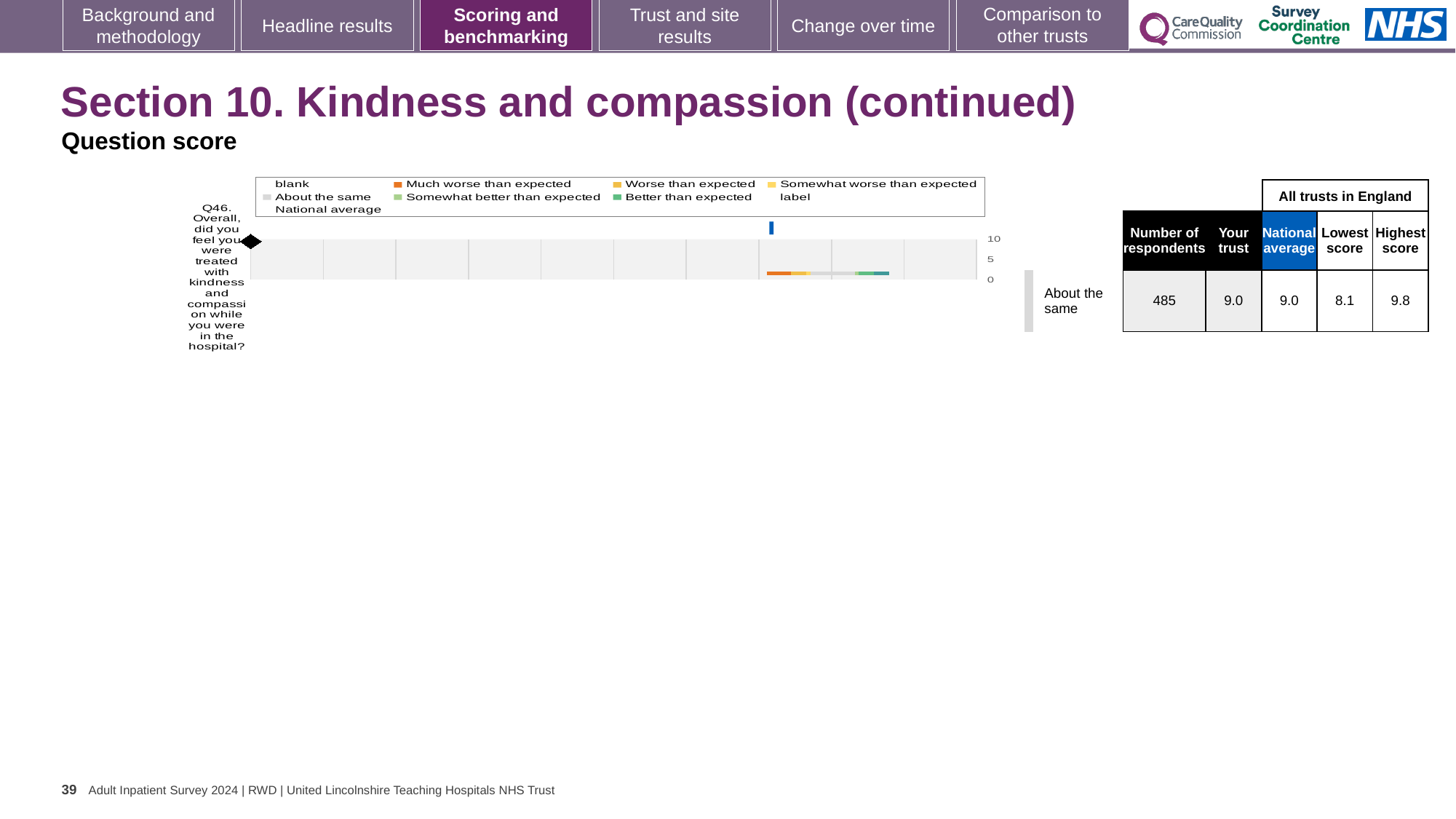
What is the difference between the highest and lowest scores for Q46 across all trusts in England? 1.7 Is the trust's score for Q46 greater or less than 5? greater What kind of chart is shown on the slide? bar chart How is the trust's result for Q46 categorised relative to expectations? About the same What is the highest score among all trusts in England for Q46? 9.8 What is the highest value shown on the chart's score axis? 10 Which question is plotted on the chart? Q46. Overall, did you feel you were treated with kindness and compassion while you were in the hospital? What is the national average score for Q46? 9.0 What is the 'Your trust' score for Q46? 9.0 How many questions (categories) are plotted on the chart? 1 How many respondents answered Q46? 485 What is the lowest score among all trusts in England for Q46? 8.1